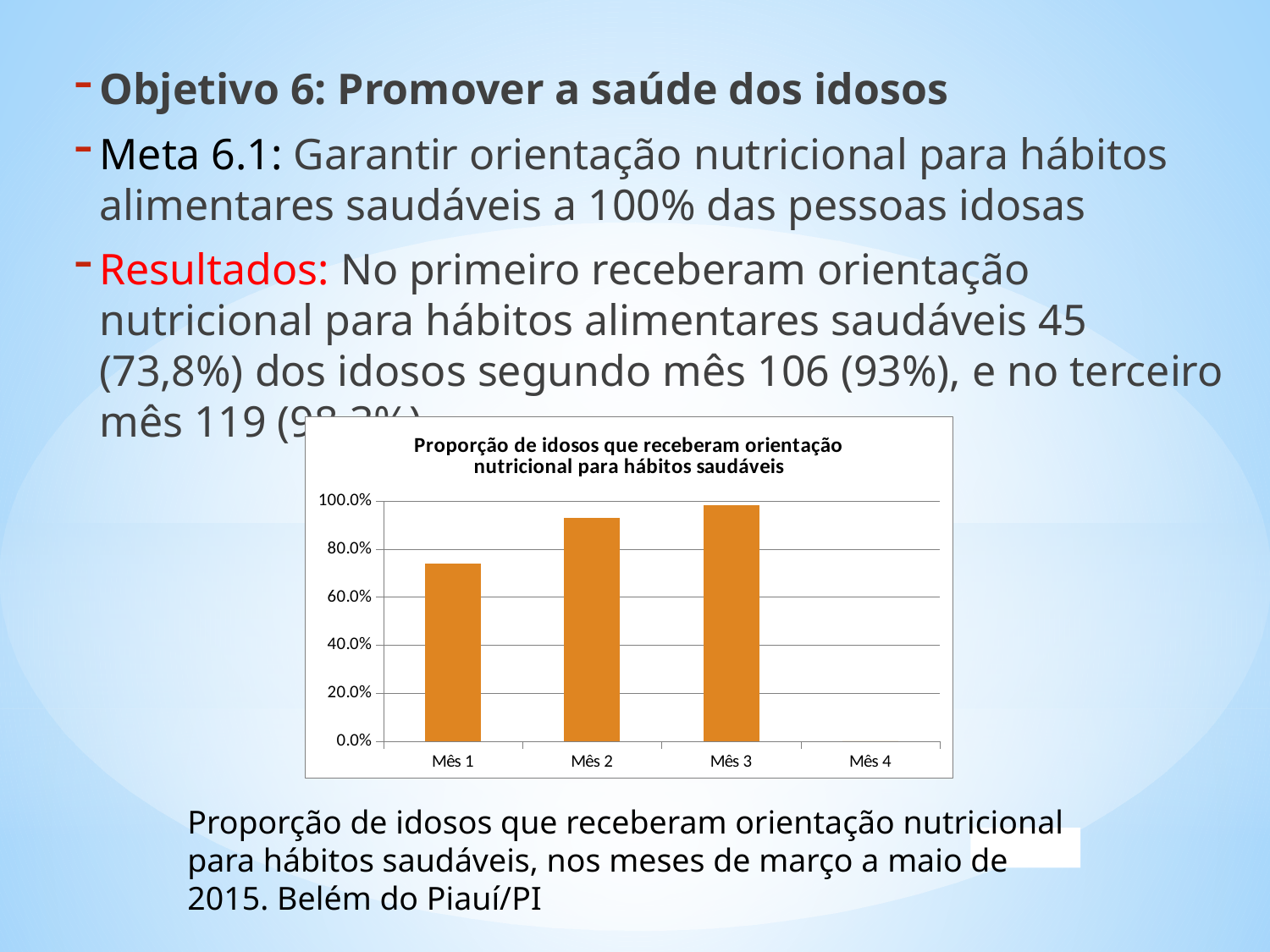
Which month has the tallest bar in the chart? Mês 3 What is the title of the chart? Proporção de idosos que receberam orientação nutricional para hábitos saudáveis Is the value for Mês 1 greater or less than 80.0%? less Which is larger, the value for Mês 1 or the value for Mês 2? Mês 2 What kind of chart is shown on the slide? bar chart Is the value for Mês 2 greater or less than 80.0%? greater Do the bar values rise or fall from Mês 1 to Mês 3? rise How many categories are shown on the x axis of the chart? 4 How many bars are plotted in the chart? 3 Is the value for Mês 1 greater or less than 60.0%? greater Among the months with a plotted bar, which has the lowest value? Mês 1